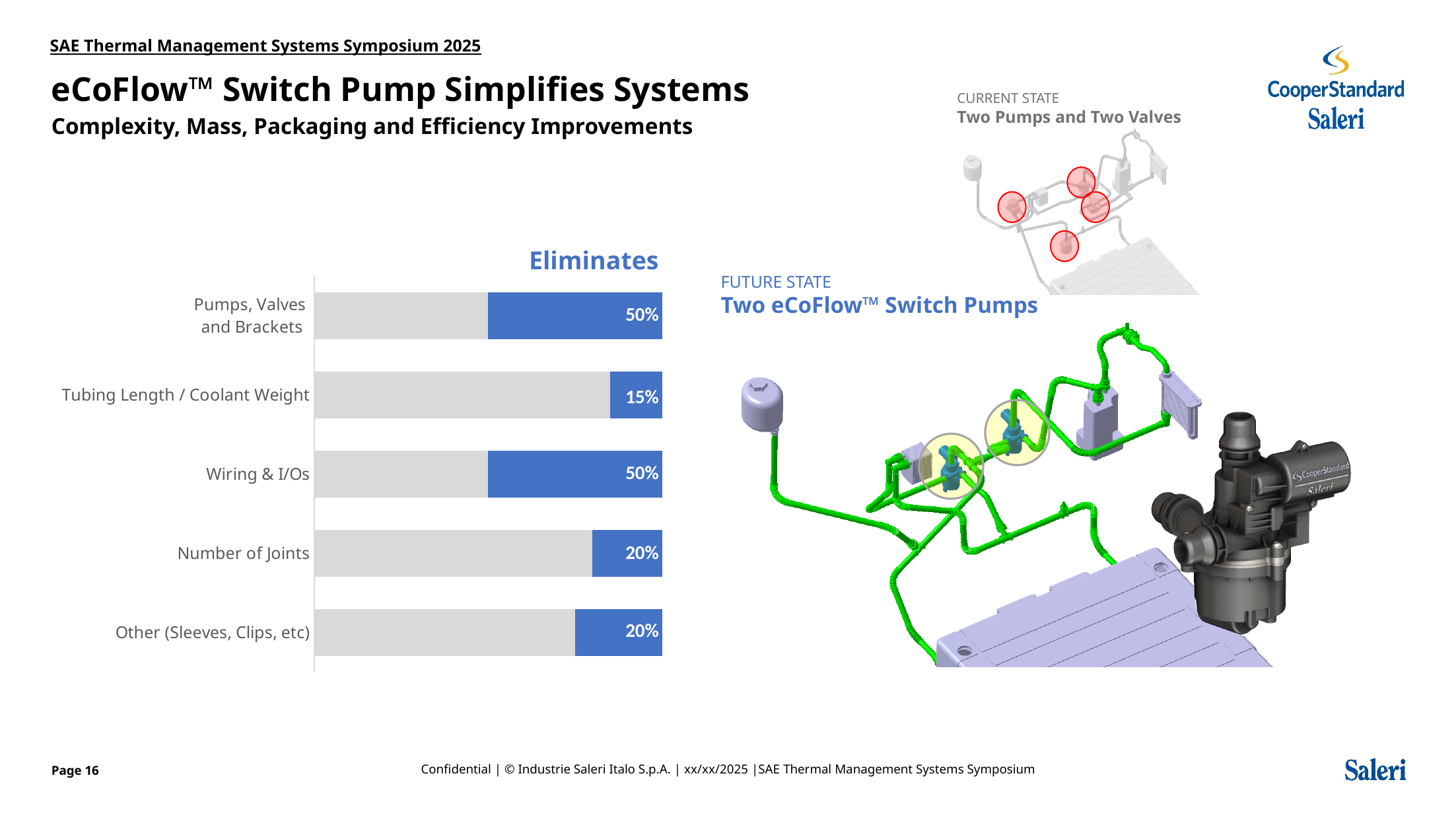
What percentage is shown for Wiring & I/Os? 50% Which is larger, the percentage for Pumps, Valves and Brackets or the percentage for Number of Joints? Pumps, Valves and Brackets What percentage is shown for Other (Sleeves, Clips, etc)? 20% What is the title of the chart? Eliminates What is the difference between the percentage for Number of Joints and the percentage for Tubing Length / Coolant Weight? 5% Which category has the lowest percentage in the chart? Tubing Length / Coolant Weight What percentage is shown for Pumps, Valves and Brackets? 50% What is the difference between the percentage for Wiring & I/Os and the percentage for Tubing Length / Coolant Weight? 35% What percentage is shown for Number of Joints? 20% How many categories are shown in the chart? 5 What percentage is shown for Tubing Length / Coolant Weight? 15% What kind of chart is shown on the slide? Bar chart